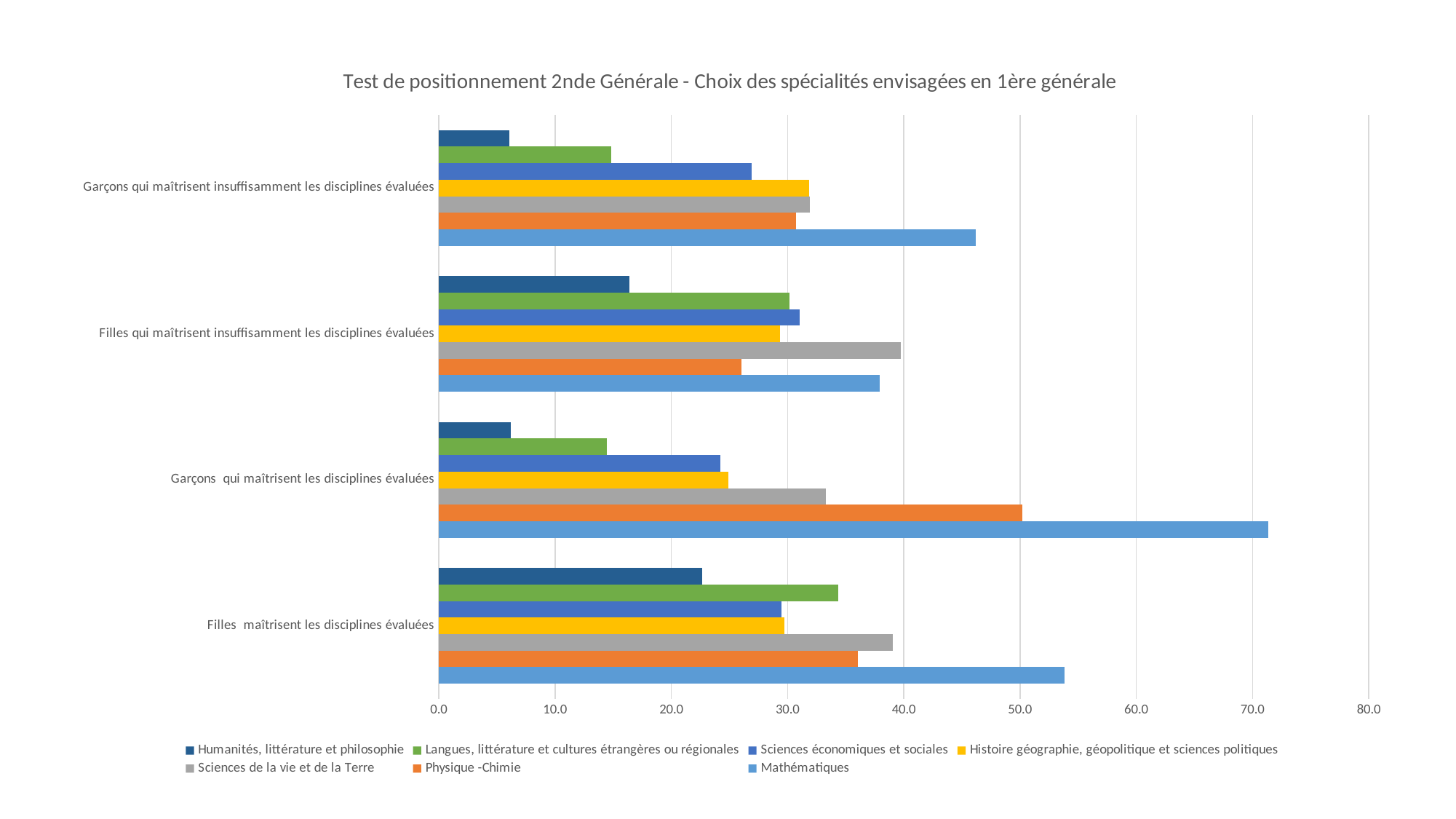
What is the title of the chart? Test de positionnement 2nde Générale - Choix des spécialités envisagées en 1ère générale How many series does the legend list? 7 Which is larger: the Physique -Chimie value for 'Garçons qui maîtrisent les disciplines évaluées' or for 'Filles maîtrisent les disciplines évaluées'? Garçons qui maîtrisent les disciplines évaluées Within 'Filles maîtrisent les disciplines évaluées', which series has the highest value? Mathématiques How many categories (student groups) are shown on the vertical axis? 4 Is the value for Humanités, littérature et philosophie for 'Garçons qui maîtrisent insuffisamment les disciplines évaluées' greater or less than 10.0? less Is the value for Sciences de la vie et de la Terre for 'Filles qui maîtrisent insuffisamment les disciplines évaluées' greater or less than 30.0? greater Is the value for Mathématiques for 'Garçons qui maîtrisent les disciplines évaluées' greater or less than 60.0? greater Which is larger: the Humanités, littérature et philosophie value for 'Filles maîtrisent les disciplines évaluées' or for 'Garçons qui maîtrisent les disciplines évaluées'? Filles maîtrisent les disciplines évaluées Which category has the highest value for Mathématiques? Garçons qui maîtrisent les disciplines évaluées Within 'Garçons qui maîtrisent les disciplines évaluées', which series has the lowest value? Humanités, littérature et philosophie What kind of chart is shown on the slide? bar chart